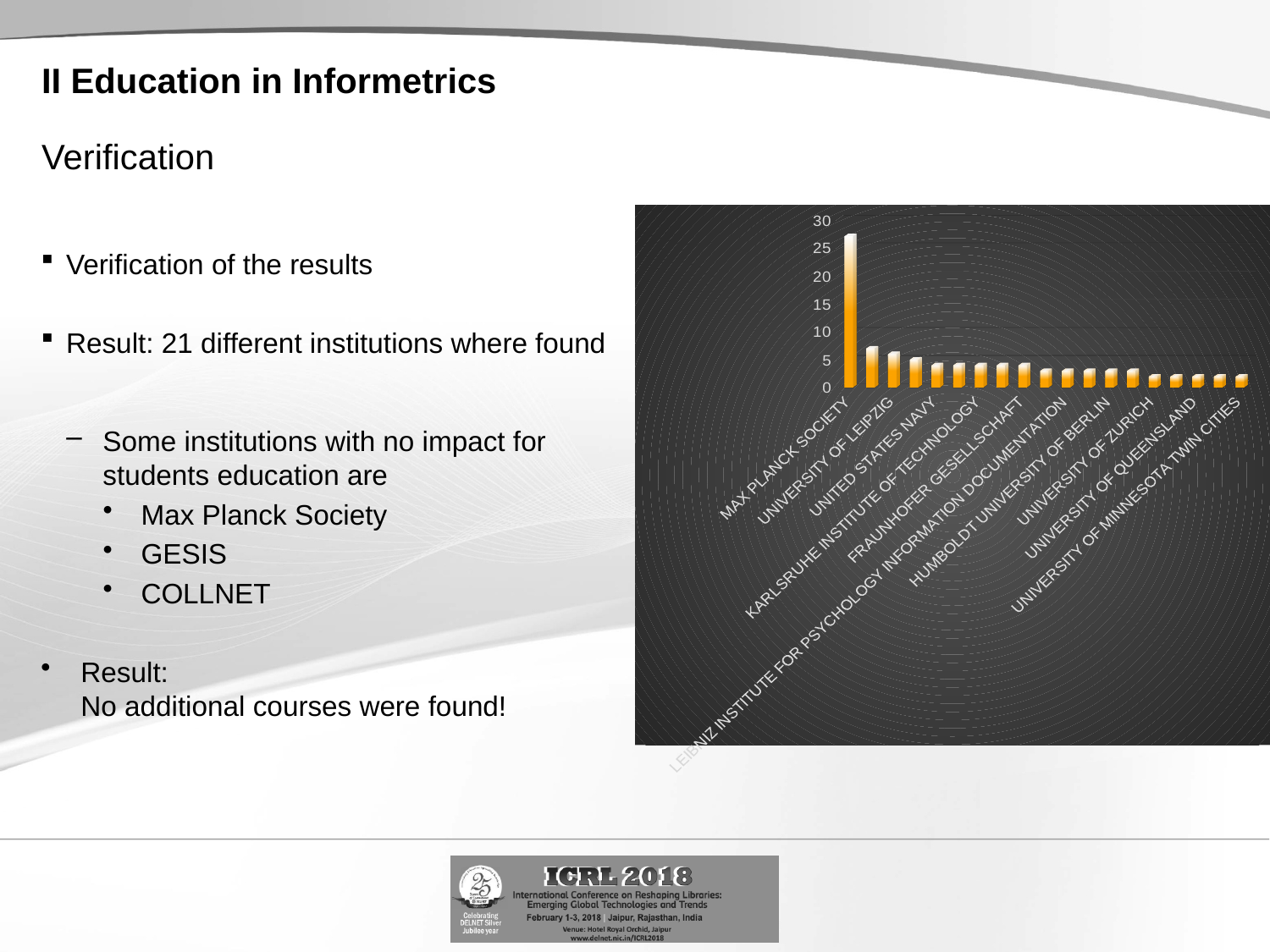
Do the bar values rise or fall from left to right along the x axis? fall Is the value for UNIVERSITY OF ZURICH greater or less than 10? less Is the value for MAX PLANCK SOCIETY greater or less than 20? greater Which institution has the highest bar in the chart? MAX PLANCK SOCIETY Which is larger, the value for MAX PLANCK SOCIETY or the value for UNIVERSITY OF LEIPZIG? MAX PLANCK SOCIETY Which is larger, the value for UNIVERSITY OF LEIPZIG or the value for UNIVERSITY OF MINNESOTA TWIN CITIES? UNIVERSITY OF LEIPZIG Is the value for UNIVERSITY OF LEIPZIG greater or less than 10? less What is the highest value shown on the vertical axis of the chart? 30 What kind of chart is shown on the slide? bar chart